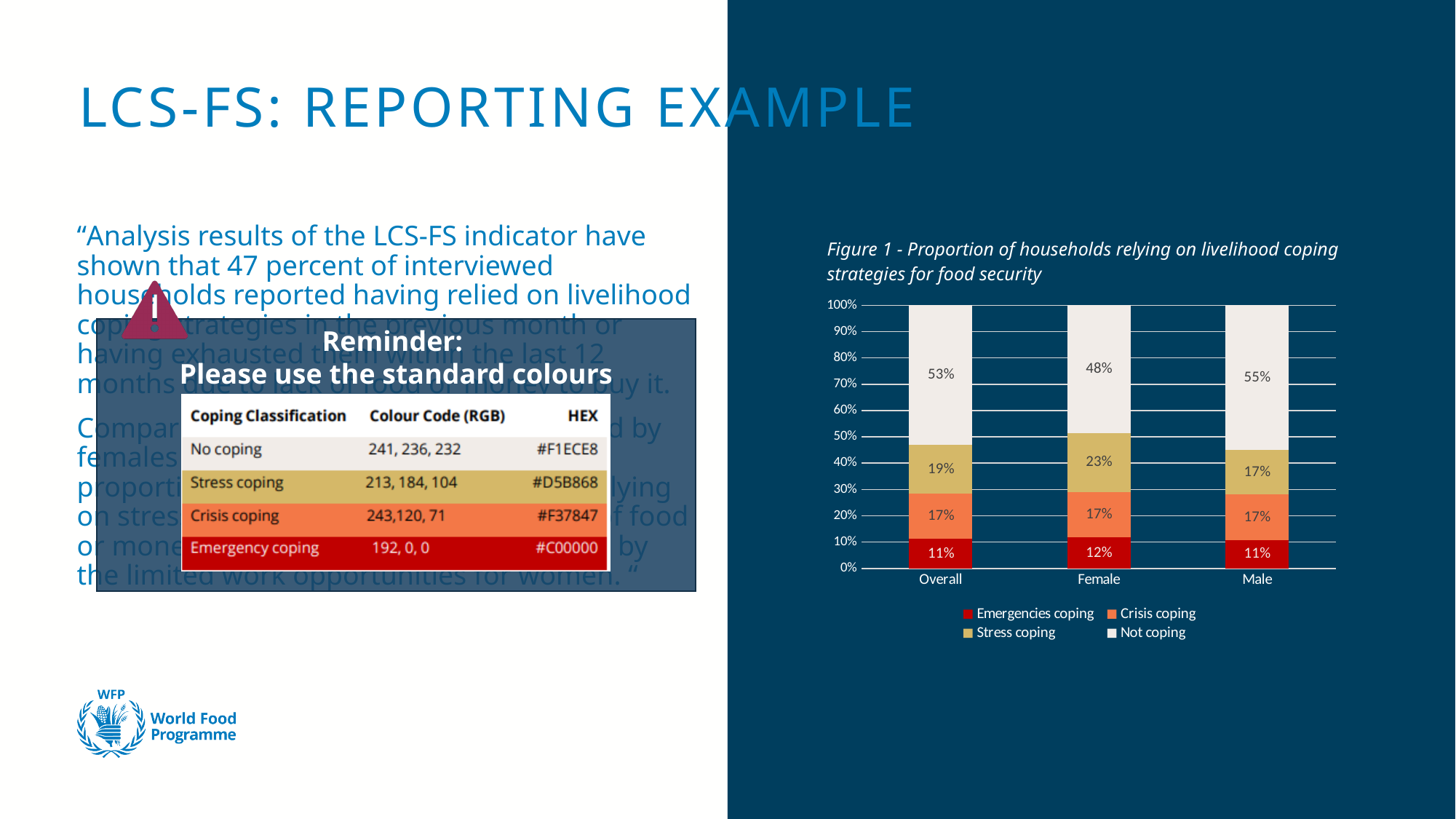
What is the Emergencies coping value for the Overall category? 11% How many categories are shown on the x axis? 3 How many series does the legend list? 4 Is the Stress coping value higher for Female or Overall households? Female Which category has the lowest Not coping share? Female Which category has the highest Not coping share? Male What is the difference between the Stress coping values for Female and Male households? 6% What kind of chart is shown? Stacked bar chart What is the Crisis coping value for Female households? 17% Which series is shown in red in the legend? Emergencies coping What percentage of Female households are in the Stress coping category? 23% What is the Not coping value for Male households? 55%